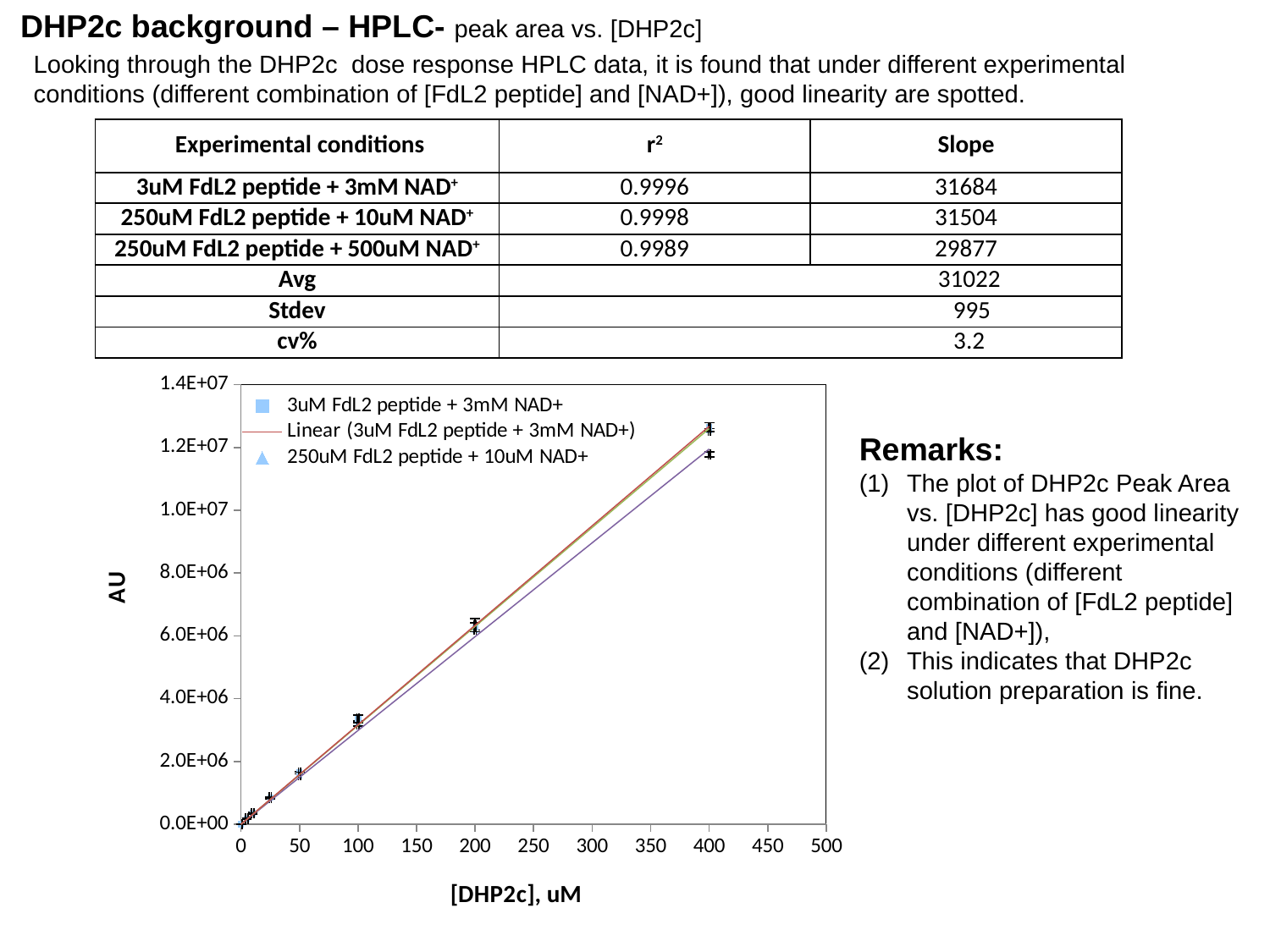
Is the value for 3uM FdL2 peptide + 3mM NAD+ at 100 uM DHP2c greater or less than 4.0E+06? less How many entries does the chart's legend list? 3 What kind of chart is shown on the slide? scatter chart with linear trendlines What is the title of the x axis of the chart? [DHP2c], uM Is the value for 3uM FdL2 peptide + 3mM NAD+ at 50 uM DHP2c greater or less than 2.0E+06? less What is the maximum value shown on the chart's x axis? 500 What is the title of the y axis of the chart? AU Do the plotted values rise or fall as [DHP2c] increases along the x axis? rise Is the value for 3uM FdL2 peptide + 3mM NAD+ at 200 uM DHP2c greater or less than 4.0E+06? greater